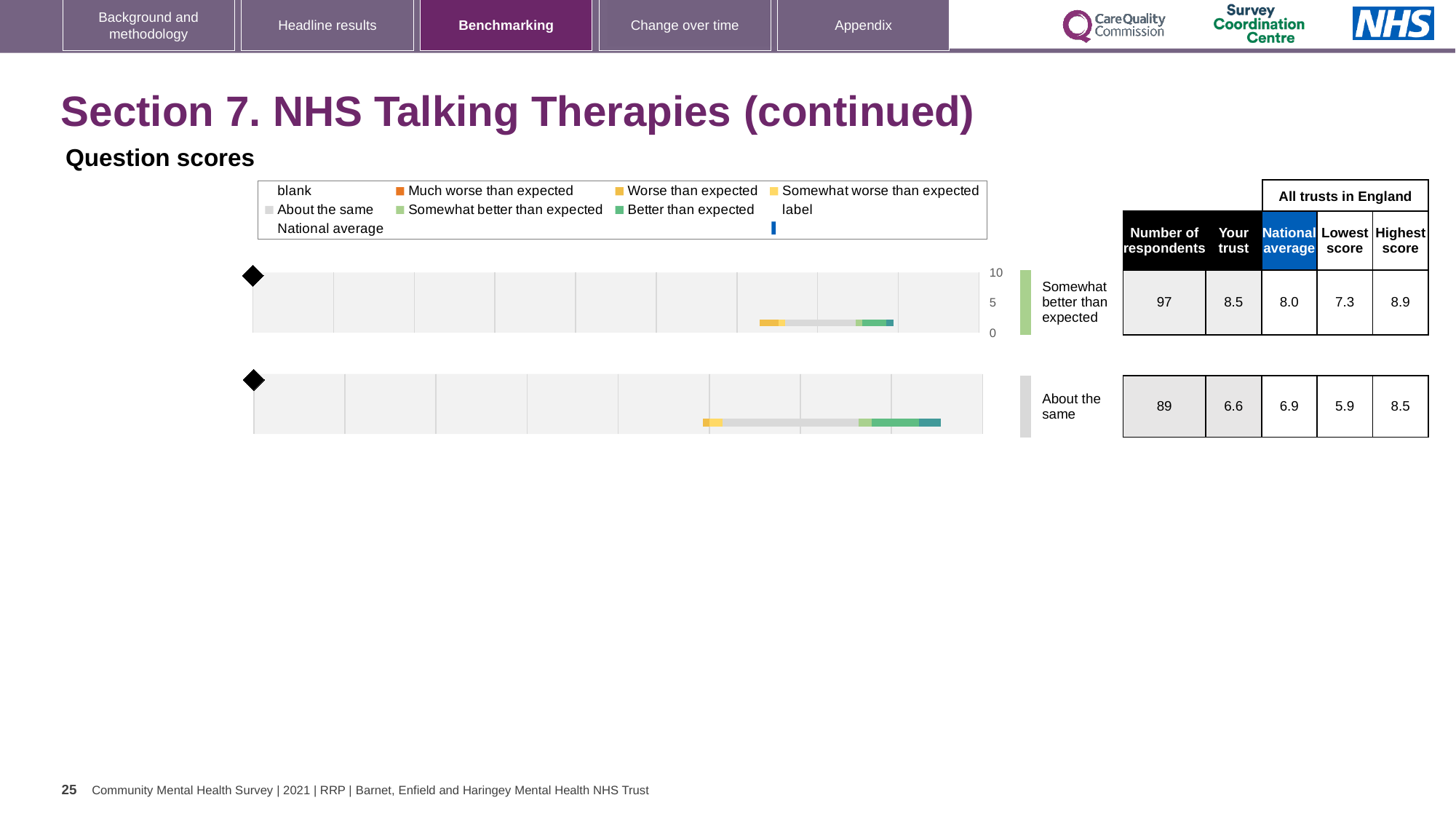
What kind of chart is used to show the question scores on this slide? Bar chart In the top chart (Somewhat better than expected), which is larger: Your trust score or the National average? Your trust For the top chart (Somewhat better than expected), what is the National average score? 8.0 For the bottom chart (About the same), what is the National average score? 6.9 For the bottom chart (About the same), what is the score for Your trust? 6.6 For the bottom chart (About the same), what is the lowest score among all trusts in England? 5.9 In the bottom chart (About the same), what is the difference between the National average and Your trust score? 0.3 In the top chart (Somewhat better than expected), what is the difference between Your trust score and the National average? 0.5 For the top chart (Somewhat better than expected), what is the score for Your trust? 8.5 In the bottom chart (About the same), which is larger: Your trust score or the National average? National average For the top chart (Somewhat better than expected), what is the highest score among all trusts in England? 8.9 How many question score charts are shown on the slide? 2